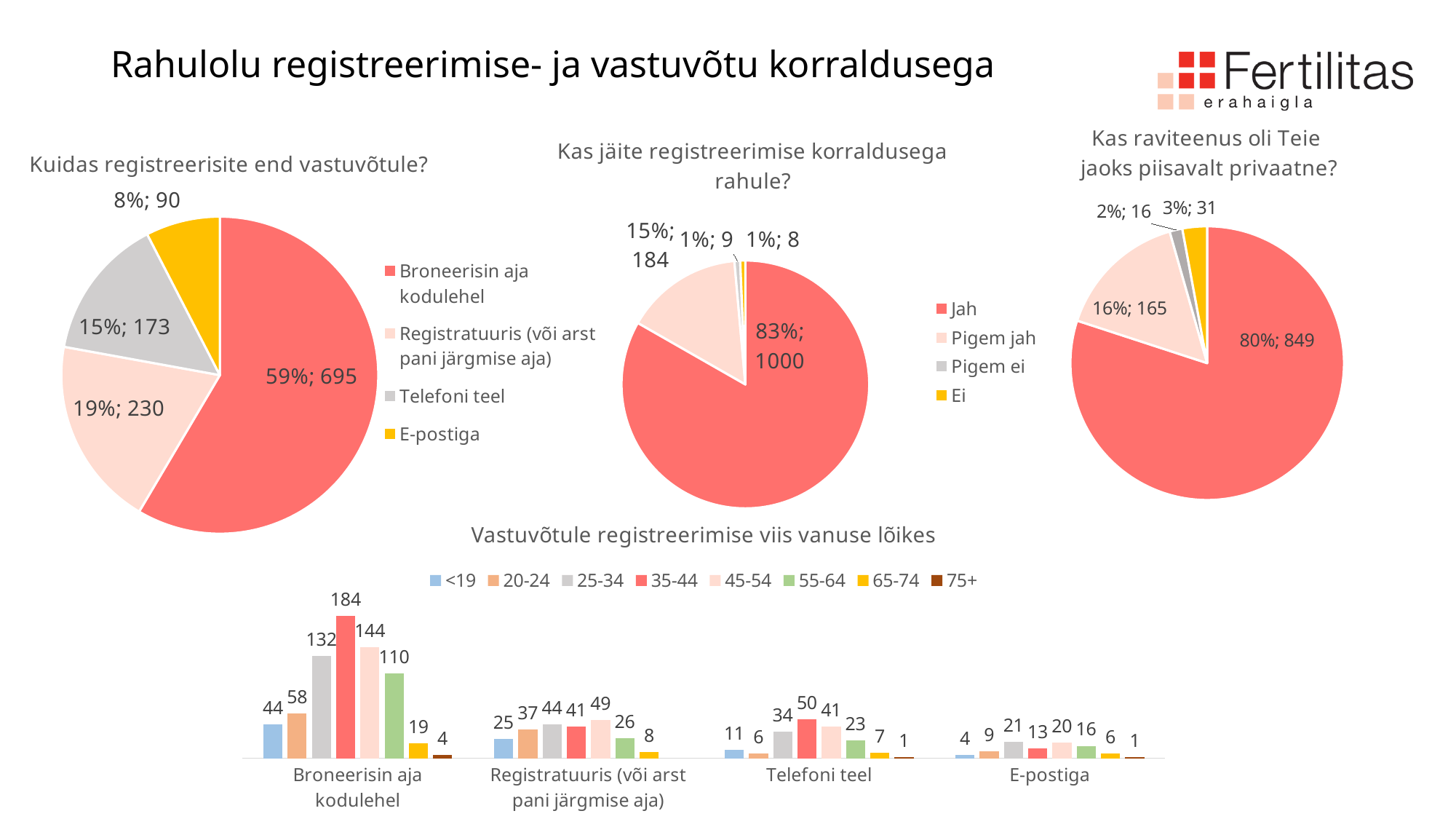
In the chart 'Vastuvõtule registreerimise viis vanuse lõikes', which age group has the highest value under 'Telefoni teel'? 35-44 In the pie chart 'Kas jäite registreerimise korraldusega rahule?', what is the difference in count between 'Pigem ei' and 'Ei'? 1 In the pie chart 'Kuidas registreerisite end vastuvõtule?', which category has the smallest slice? E-postiga In the pie chart 'Kuidas registreerisite end vastuvõtule?', what share of respondents chose 'Broneerisin aja kodulehel'? 59% In the pie chart 'Kuidas registreerisite end vastuvõtule?', how many respondents registered 'Telefoni teel'? 173 In the pie chart 'Kas raviteenus oli Teie jaoks piisavalt privaatne?', which is larger, the count for 'Ei' or for 'Pigem ei'? Ei What kind of chart is 'Vastuvõtule registreerimise viis vanuse lõikes'? Bar chart In the chart 'Vastuvõtule registreerimise viis vanuse lõikes', what is the value for the 35-44 age group under 'Broneerisin aja kodulehel'? 184 In the chart 'Vastuvõtule registreerimise viis vanuse lõikes', what is the difference between the 25-34 and 45-54 values under 'E-postiga'? 1 How many series does the legend of the chart 'Vastuvõtule registreerimise viis vanuse lõikes' list? 8 In the pie chart 'Kas raviteenus oli Teie jaoks piisavalt privaatne?', what share of respondents answered 'Pigem jah'? 16% In the pie chart 'Kas jäite registreerimise korraldusega rahule?', how many respondents answered 'Jah'? 1000